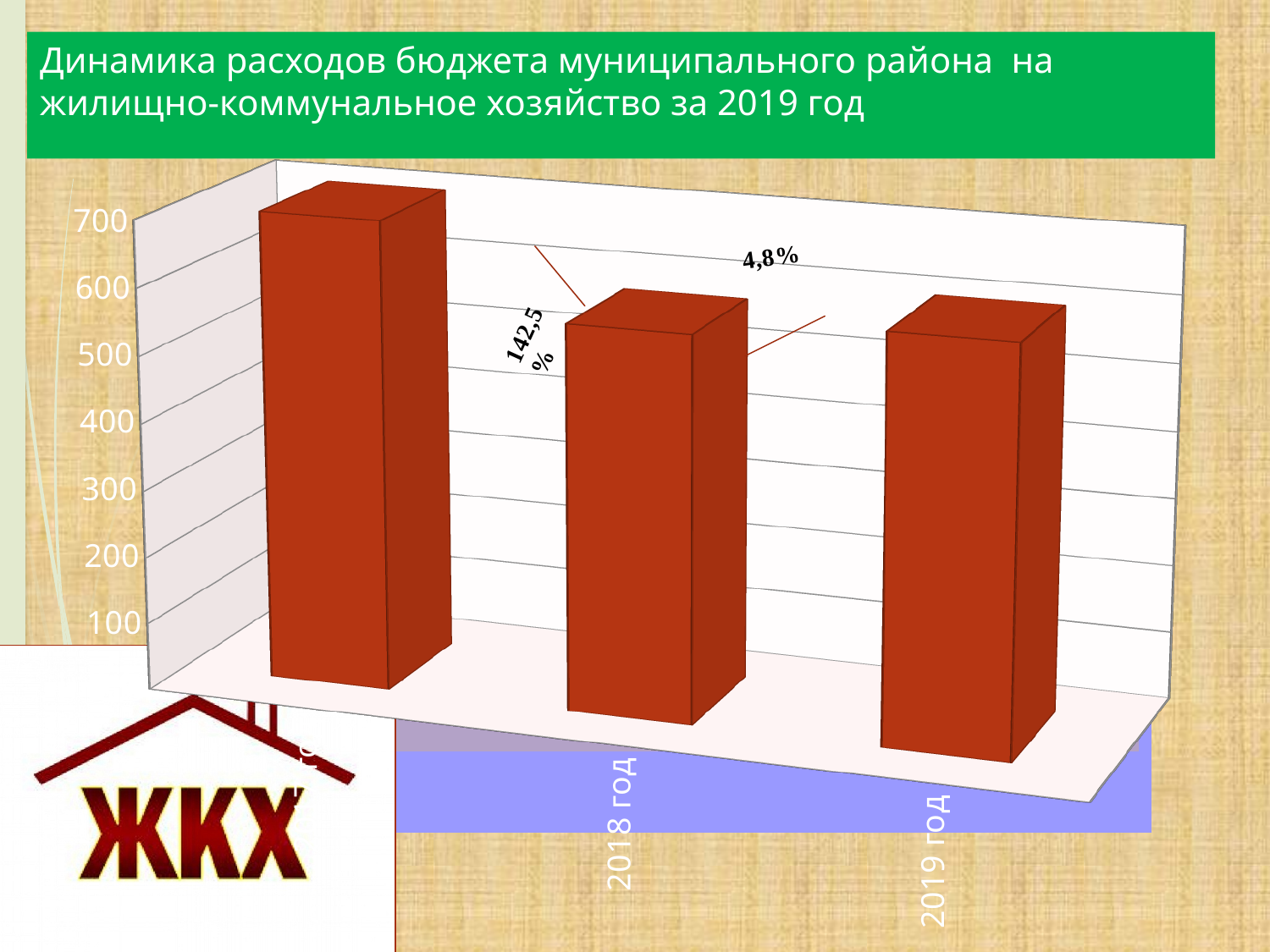
How many bars are plotted in the chart? 3 What percentage annotation is written next to the 2019 год bar? 4,8% Do the bar values rise or fall from left to right along the x axis? fall, then rise What kind of chart is shown on the slide? bar chart Is the value for 2018 год greater or less than 400? greater Is the value for 2018 год greater or less than 700? less Is the value for 2019 год greater or less than 700? less What is the title of the chart on the slide? Динамика расходов бюджета муниципального района на жилищно-коммунальное хозяйство за 2019 год